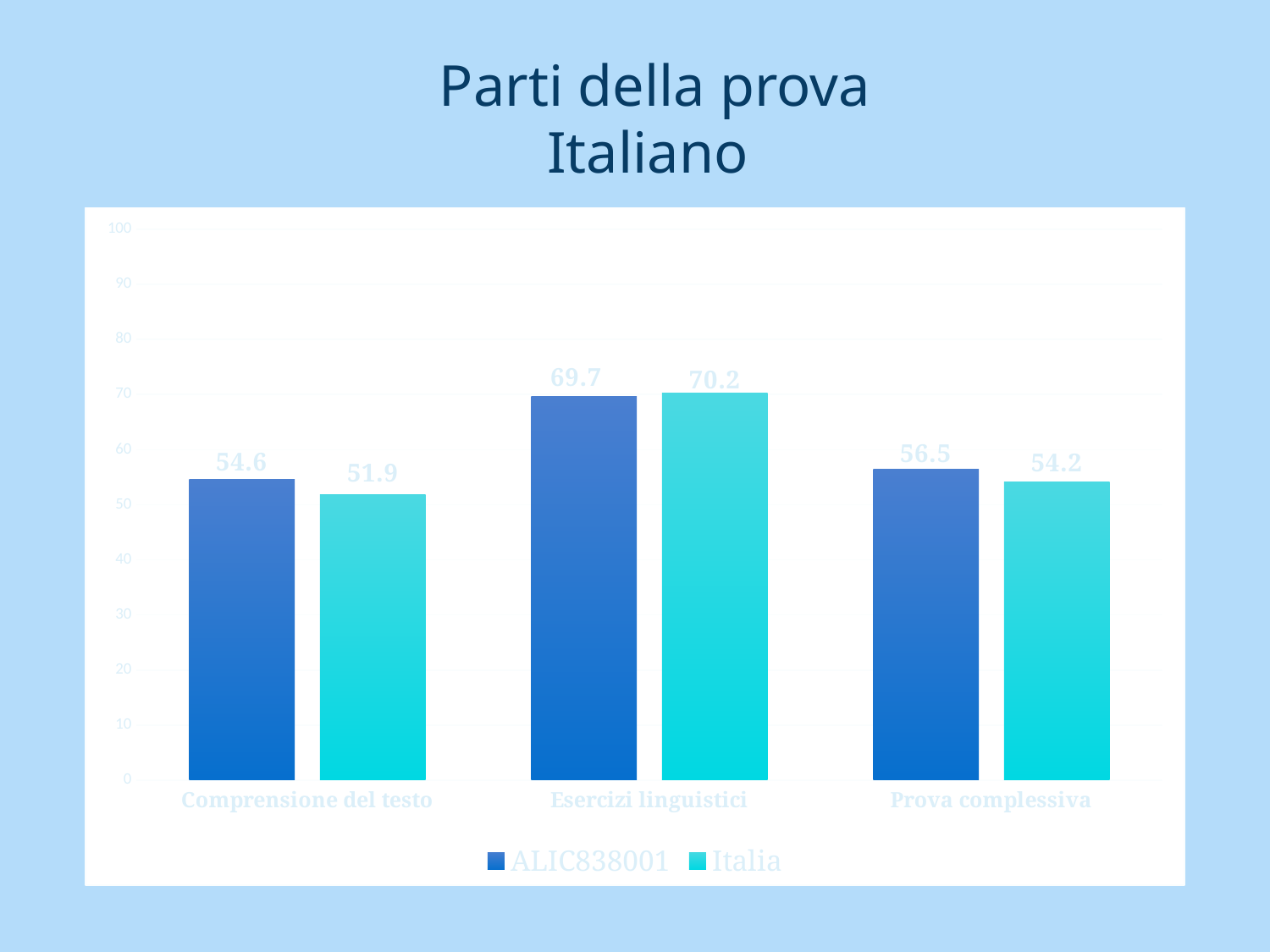
What is the difference between ALIC838001 and Italia in Comprensione del testo? 2.7 What is the value for ALIC838001 in Comprensione del testo? 54.6 Which is larger in Comprensione del testo, ALIC838001 or Italia? ALIC838001 Which category has the lowest value for Italia? Comprensione del testo How many series does the legend list? 2 Which category has the highest value for ALIC838001? Esercizi linguistici How many categories are shown on the x axis? 3 What is the value for ALIC838001 in Prova complessiva? 56.5 What is the value for Italia in Comprensione del testo? 51.9 What kind of chart is shown on the slide? Bar chart What is the difference between ALIC838001 and Italia in Prova complessiva? 2.3 What is the value for Italia in Esercizi linguistici? 70.2